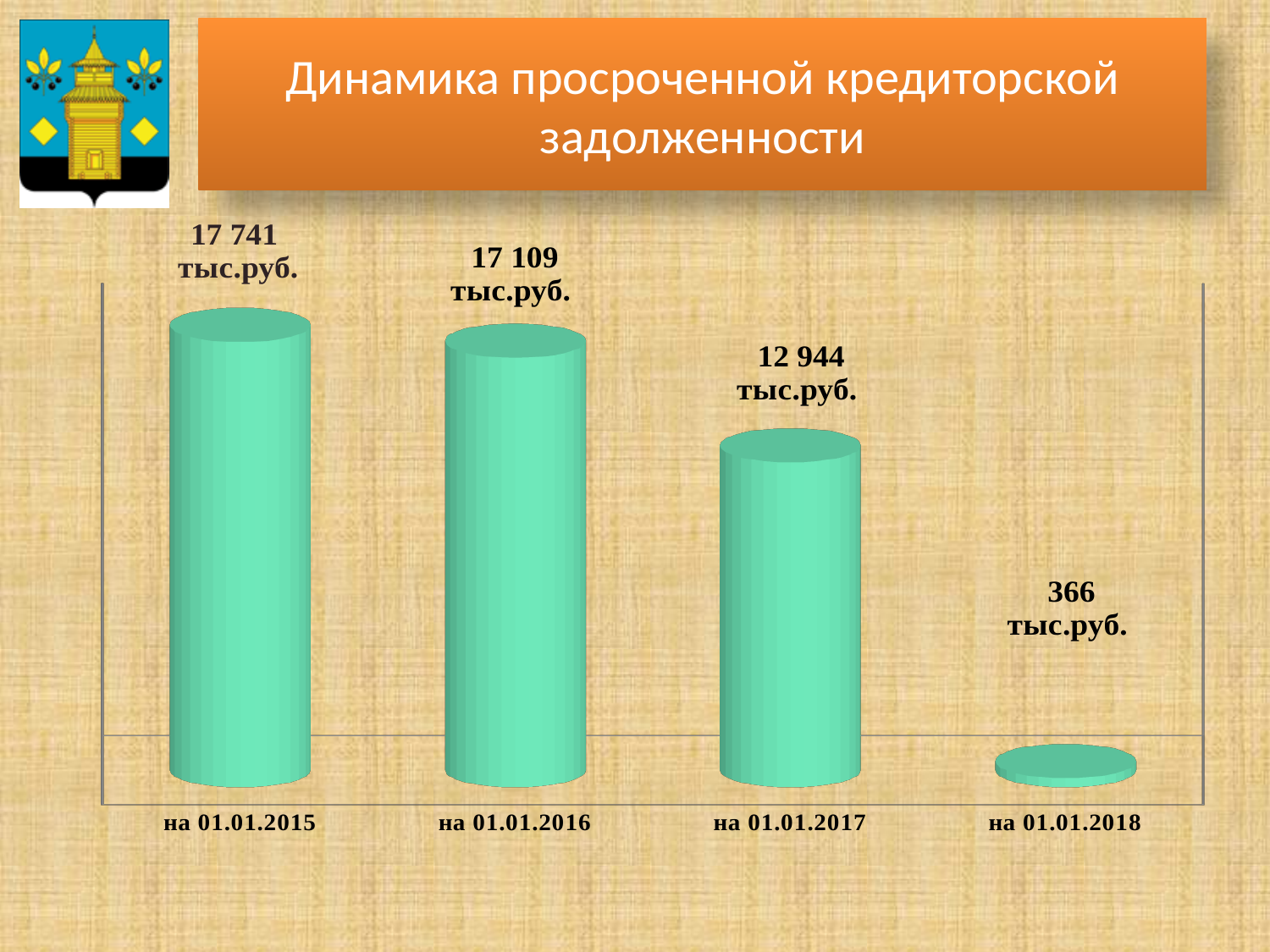
What is the value for на 01.01.2018? 366 тыс.руб. Which date has the highest value? на 01.01.2015 How many dates are shown on the chart? 4 What kind of chart is shown on the slide? Bar chart What is the difference between the values for на 01.01.2017 and на 01.01.2018? 12 578 тыс.руб. What is the value for на 01.01.2016? 17 109 тыс.руб. Which is larger, the value for на 01.01.2016 or the value for на 01.01.2017? на 01.01.2016 What is the value for на 01.01.2015? 17 741 тыс.руб. Which date has the lowest value? на 01.01.2018 What is the value for на 01.01.2017? 12 944 тыс.руб. What is the difference between the values for на 01.01.2015 and на 01.01.2016? 632 тыс.руб. Do the values rise or fall from на 01.01.2015 to на 01.01.2018? Fall